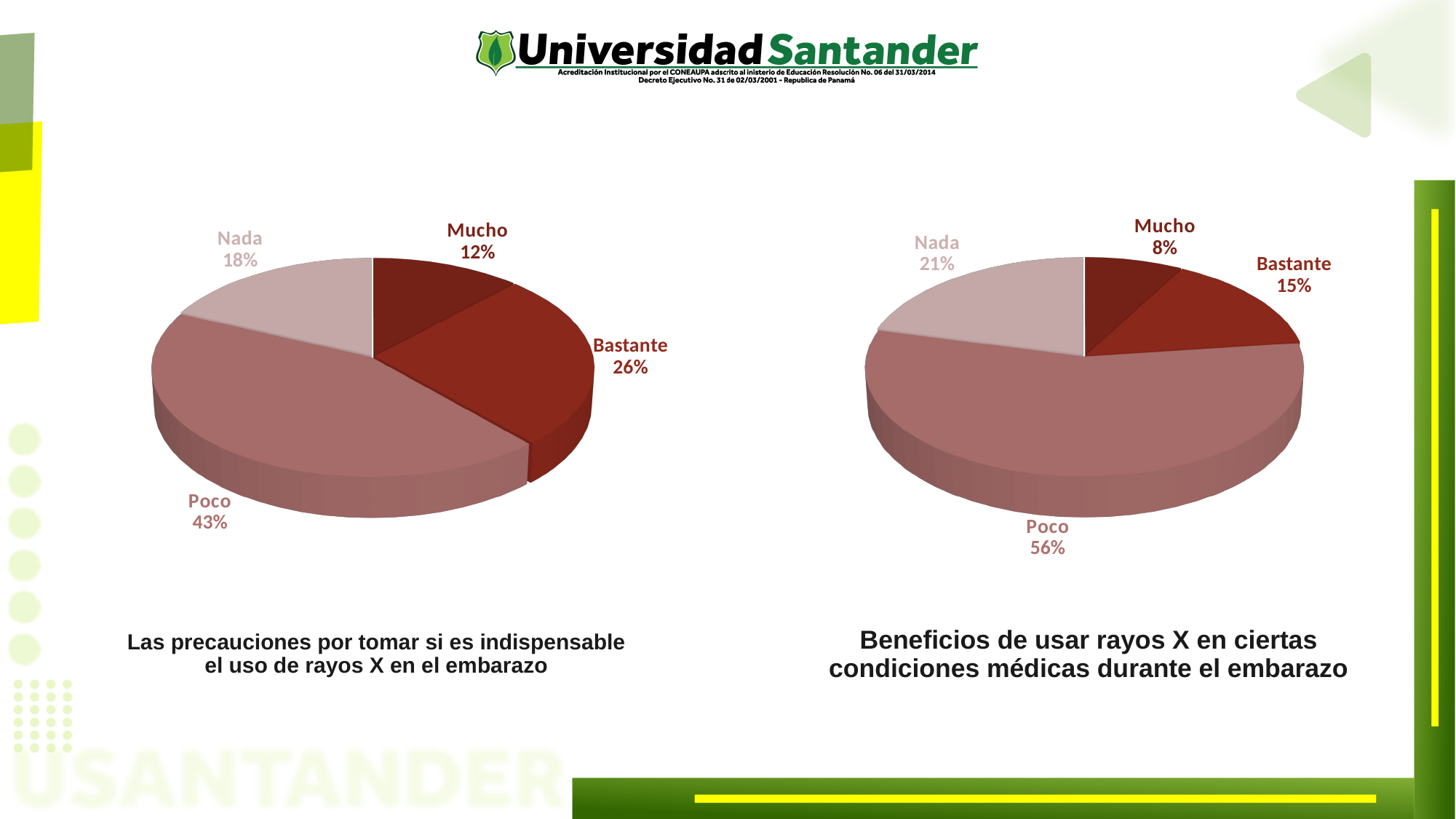
In the left pie chart, which category has the largest share? Poco How many slices does the left pie chart have? 4 What type of chart is used on the right side of the slide? Pie chart In the left pie chart (Las precauciones por tomar si es indispensable el uso de rayos X en el embarazo), what percentage is shown for Poco? 43% In the right pie chart (Beneficios de usar rayos X en ciertas condiciones médicas durante el embarazo), what percentage is shown for Nada? 21% In the left pie chart, what is the difference between the Bastante and Mucho percentages? 14% What is the title of the chart on the left side of the slide? Las precauciones por tomar si es indispensable el uso de rayos X en el embarazo In the right pie chart, which category has the smallest share? Mucho In the right pie chart, what percentage is shown for Mucho? 8% In the right pie chart, which is larger: Mucho or Bastante? Bastante In the left pie chart, which is larger: Nada or Bastante? Bastante In the right pie chart, what is the difference between the Poco and Nada percentages? 35%